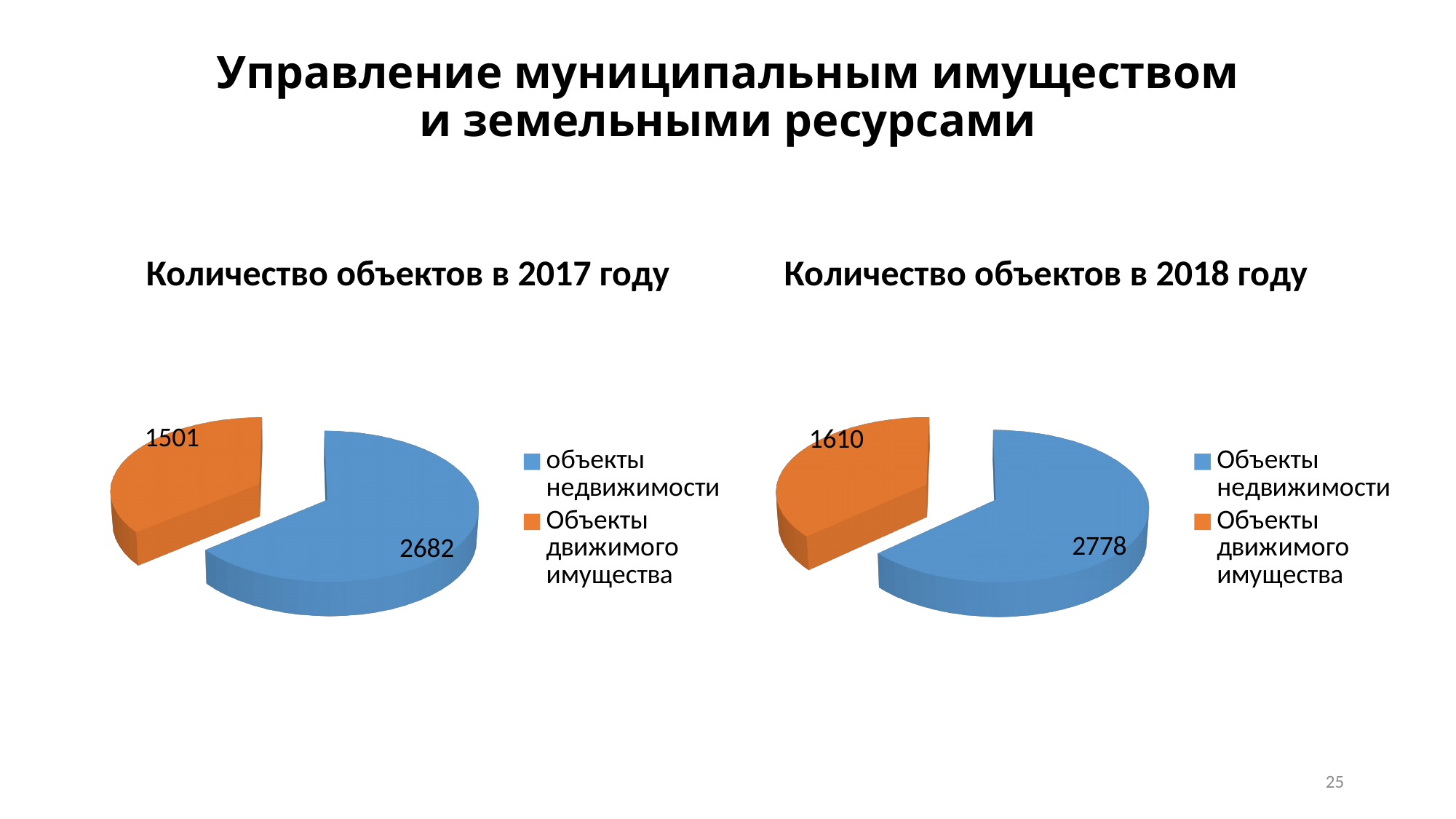
In the chart titled "Количество объектов в 2017 году", what is the value for Объекты движимого имущества? 1501 In the chart titled "Количество объектов в 2018 году", what is the value for Объекты недвижимости? 2778 In the chart titled "Количество объектов в 2018 году", what is the total of all slices? 4388 In the chart titled "Количество объектов в 2018 году", which category has the smallest slice? Объекты движимого имущества In the chart titled "Количество объектов в 2018 году", what is the value for Объекты движимого имущества? 1610 In the chart titled "Количество объектов в 2018 году", what is the difference between Объекты недвижимости and Объекты движимого имущества? 1168 In the chart titled "Количество объектов в 2017 году", what is the difference between объекты недвижимости and Объекты движимого имущества? 1181 In the chart titled "Количество объектов в 2017 году", which category has the largest slice? объекты недвижимости In the chart titled "Количество объектов в 2017 году", what is the value for объекты недвижимости? 2682 What type of chart is the chart titled "Количество объектов в 2017 году"? Pie chart Which is larger: Объекты движимого имущества in the 2017 chart or in the 2018 chart? 2018 chart How many slices does the chart titled "Количество объектов в 2018 году" have? 2